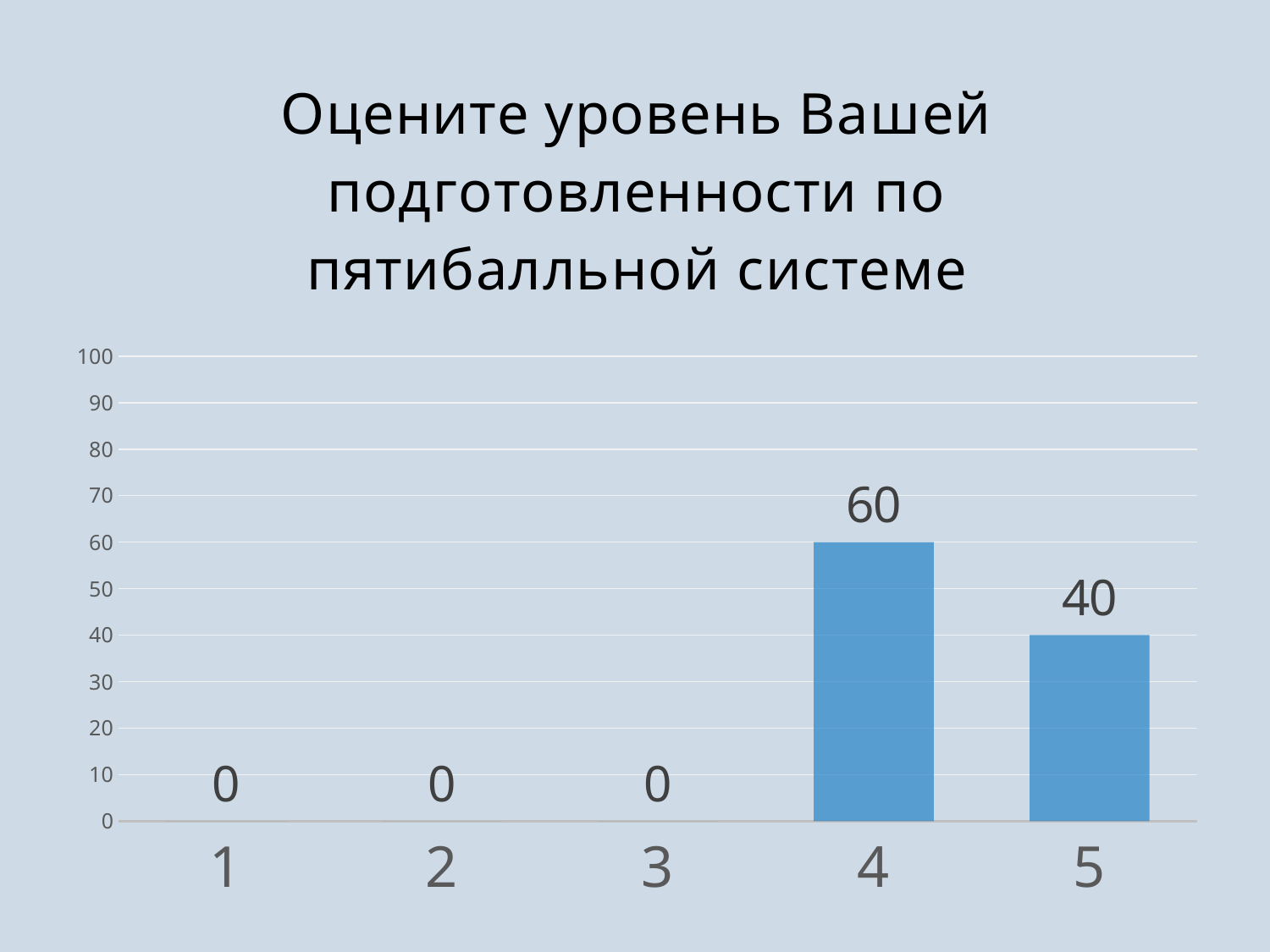
What is the maximum value shown on the vertical axis? 100 What is the value for category 5? 40 What is the difference between the values for categories 4 and 5? 20 How many categories are shown on the x axis? 5 Which is larger, the value for category 4 or the value for category 5? 4 Is the value for category 4 greater or less than 50? greater What is the total of the values for categories 4 and 5? 100 Which category has the highest value? 4 How many categories have a value of 0? 3 What is the value for category 1? 0 What is the value for category 4? 60 What kind of chart is shown on the slide? bar chart